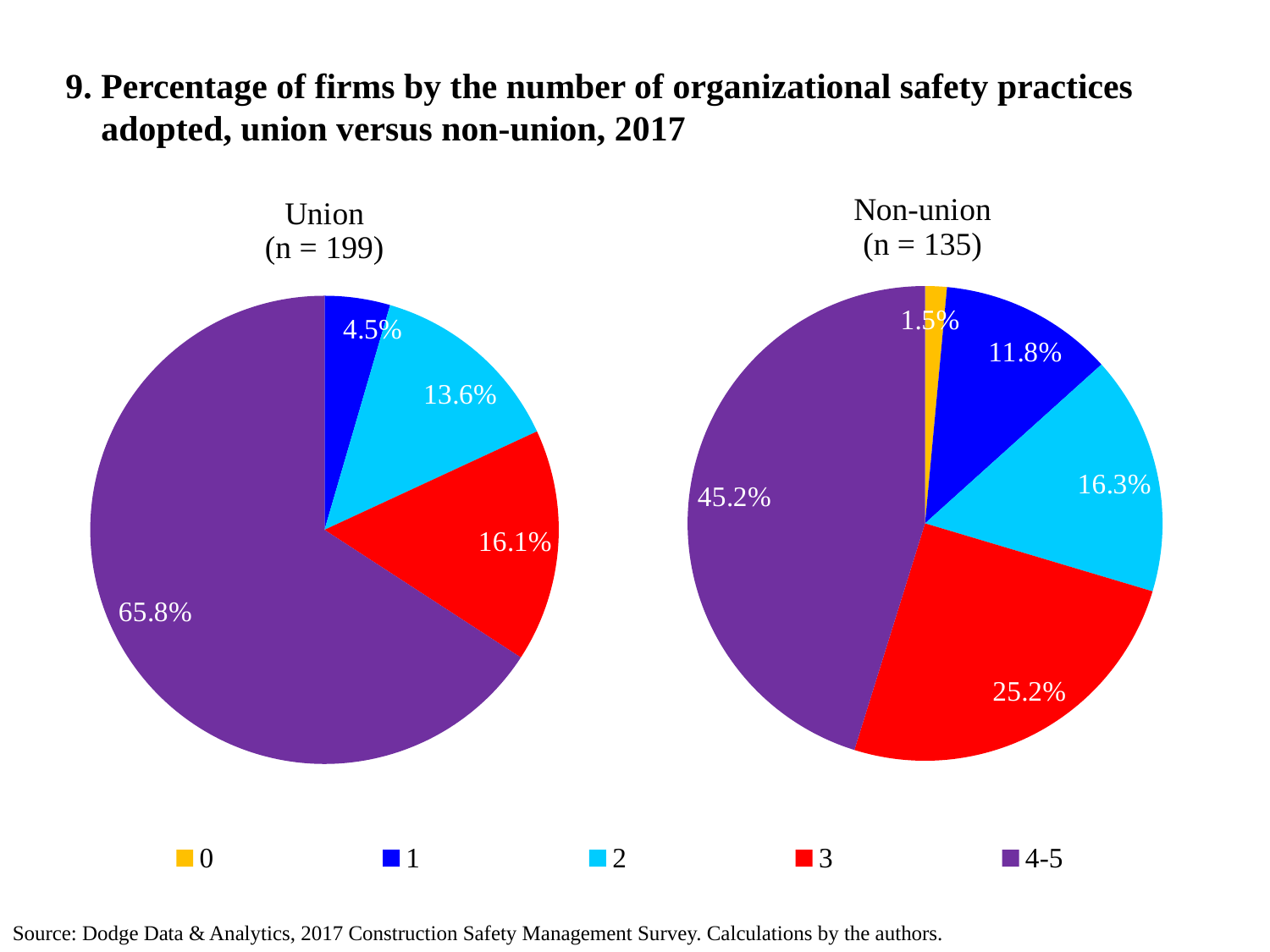
In the Non-union pie chart, what percentage of firms adopted 3 organizational safety practices? 25.2% In the Non-union pie chart, which category has the smallest share? 0 How many categories does the legend list? 5 What is the difference between the share of firms adopting 4-5 practices in the Union chart and in the Non-union chart? 20.6% What type of chart is used for the Union and Non-union data? Pie chart In the Union pie chart, what percentage of firms adopted 1 organizational safety practice? 4.5% In the Union pie chart, what percentage of firms adopted 4-5 organizational safety practices? 65.8% What is the sample size (n) shown for the Non-union pie chart? 135 In the Non-union pie chart, what percentage of firms adopted 0 organizational safety practices? 1.5% In the Union pie chart, what is the difference between the shares for 3 practices and 2 practices? 2.5% In the Non-union pie chart, which category has the largest share? 4-5 Which is larger: the share of firms adopting 2 practices in the Union chart or in the Non-union chart? Non-union